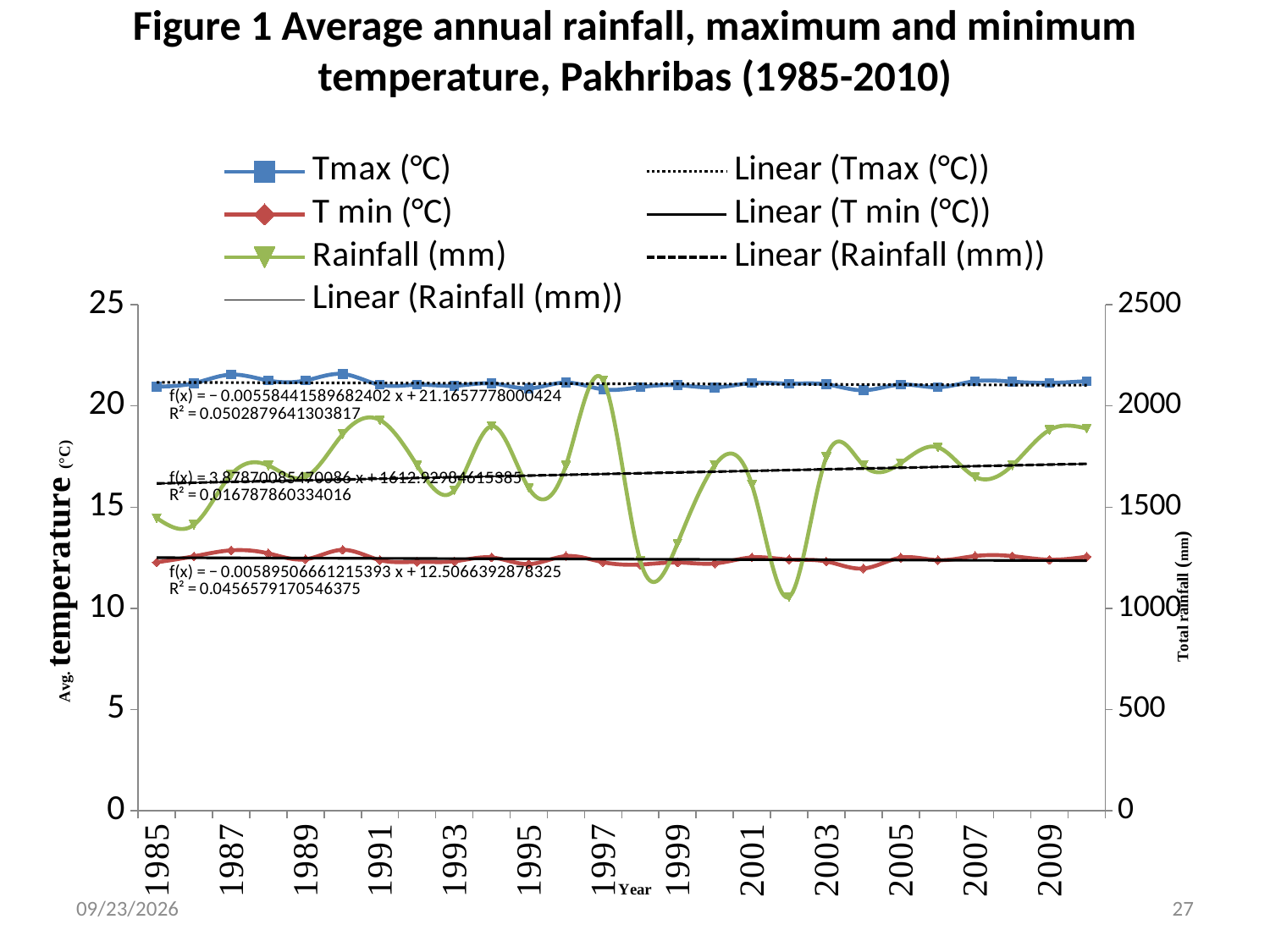
What kind of chart is shown on the slide? line chart Is the Tmax (°C) value for 1985 greater or less than 20? greater What is the title of the chart? Figure 1 Average annual rainfall, maximum and minimum temperature, Pakhribas (1985-2010) Is the rainfall value for 1998 greater or less than 1500? less What is the maximum value shown on the right-hand (Total rainfall) axis? 2500 Does the linear trendline for Rainfall (mm) rise or fall from 1985 to 2010? rise How many entries does the chart legend list? 7 Which series has larger values in 2005, Tmax (°C) or T min (°C)? Tmax (°C) Is the rainfall value for 2002 greater or less than 1500? less Which year has the highest rainfall in the chart? 1997 Which year has the lowest rainfall in the chart? 2002